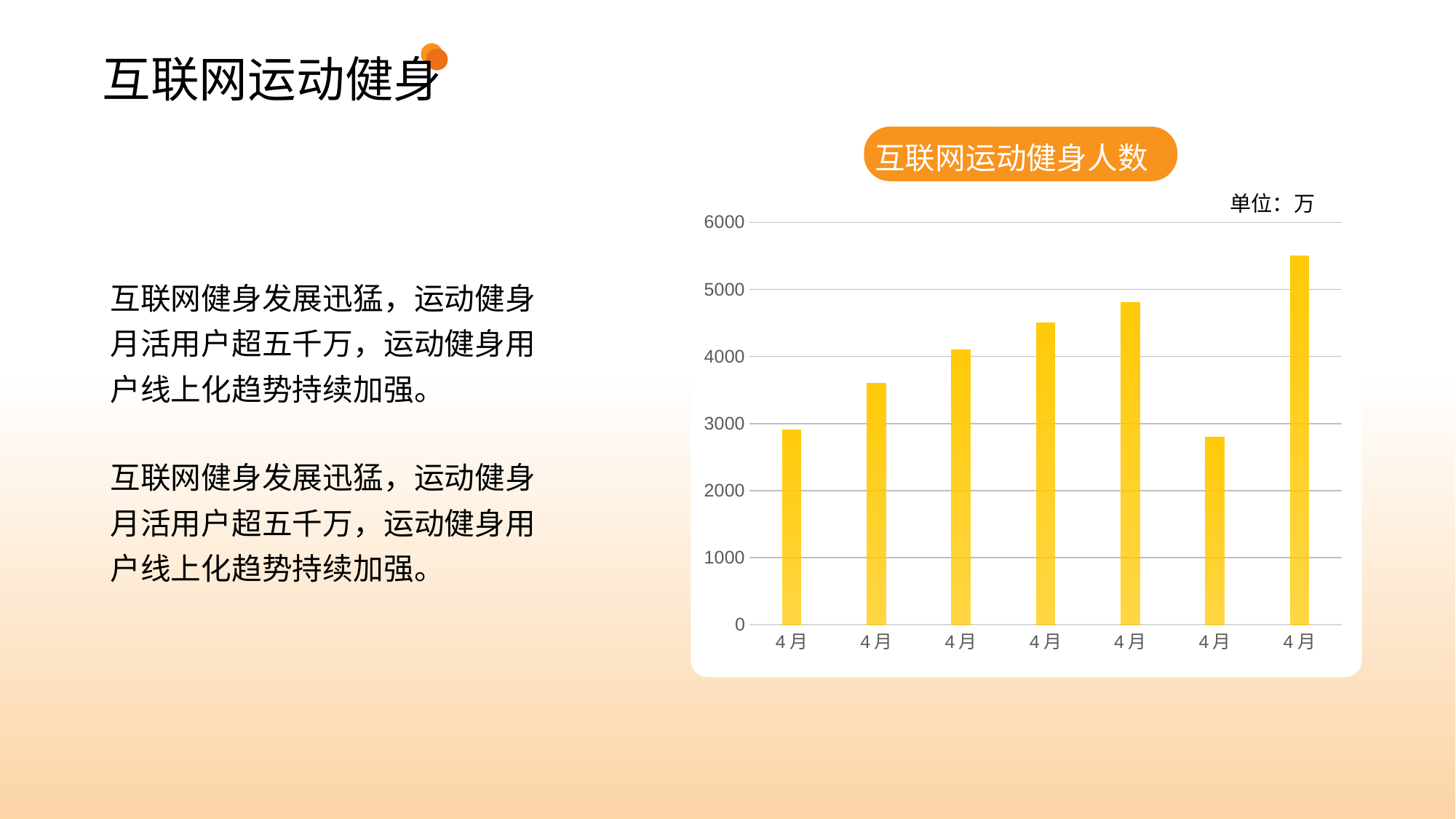
Which is larger, the fifth bar or the seventh bar? the seventh bar What kind of chart is shown on the slide? bar chart Do the values rise or fall from the first bar to the fifth bar? rise Is the value of the second bar greater or less than 3000? greater Which bar is the highest in the chart? the seventh (rightmost) bar Is the value of the seventh (rightmost) bar greater or less than 5000? greater How many bars are plotted in the chart? 7 Is the value of the fourth bar greater or less than 4000? greater What is the title of the chart? 互联网运动健身人数